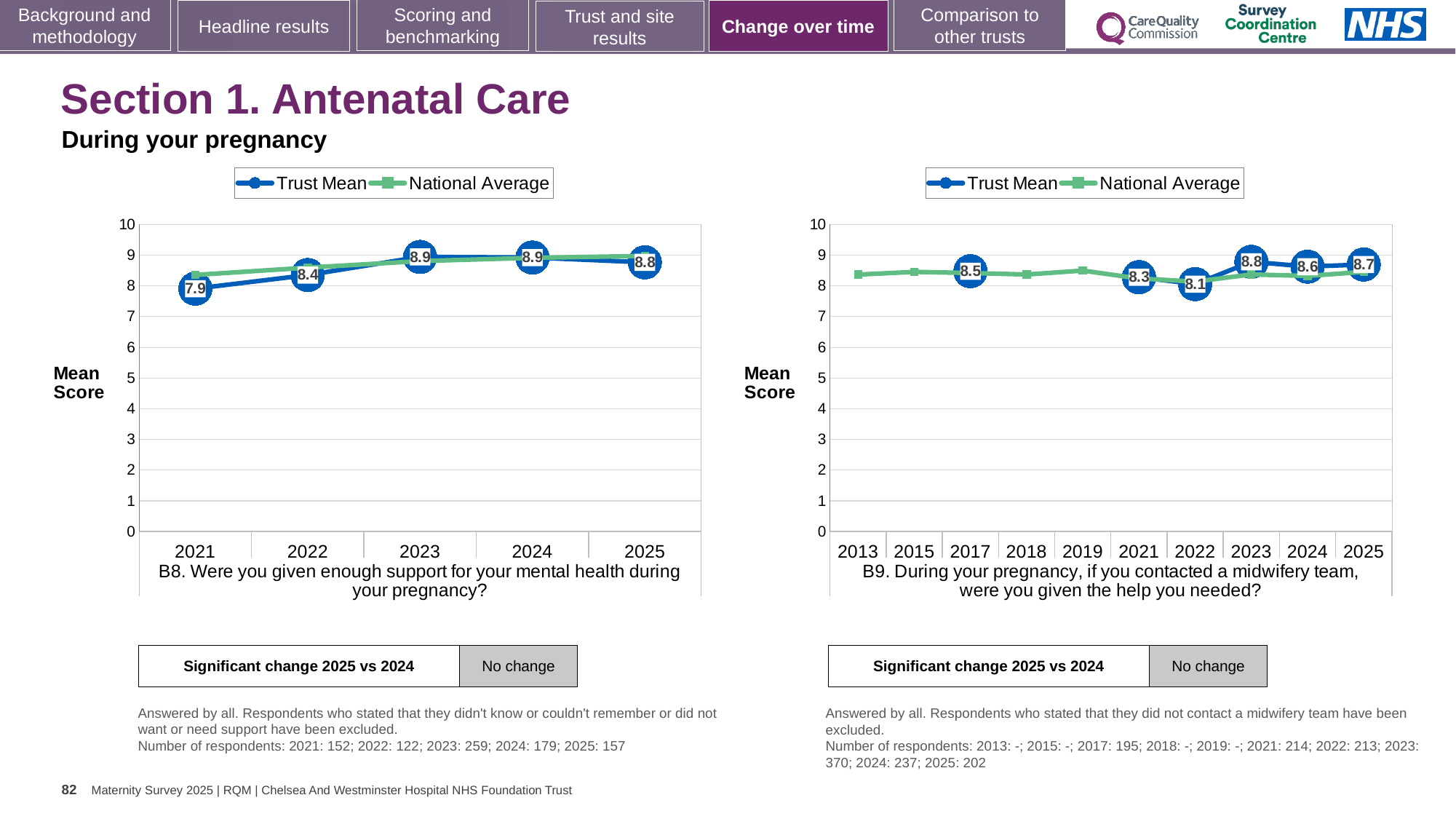
In the right chart (B9), which year has the lowest labelled Trust Mean? 2022 How many series does the legend of the left chart (B8) list? 2 In the right chart (B9), what is the Trust Mean for 2022? 8.1 What kind of chart is the right chart (B9)? Line chart In the right chart (B9), what is the Trust Mean for 2023? 8.8 In the right chart (B9), is the Trust Mean for 2025 larger or smaller than the Trust Mean for 2024? larger In the left chart (B8), what is the Trust Mean for 2021? 7.9 In the right chart (B9), how many years are shown on the x axis? 10 In the left chart (B8), which year has the lowest Trust Mean? 2021 In the left chart (B8), what is the difference between the Trust Mean in 2023 and in 2021? 1.0 In the left chart (B8), how many years are shown on the x axis? 5 In the left chart (B8), what is the Trust Mean for 2025? 8.8